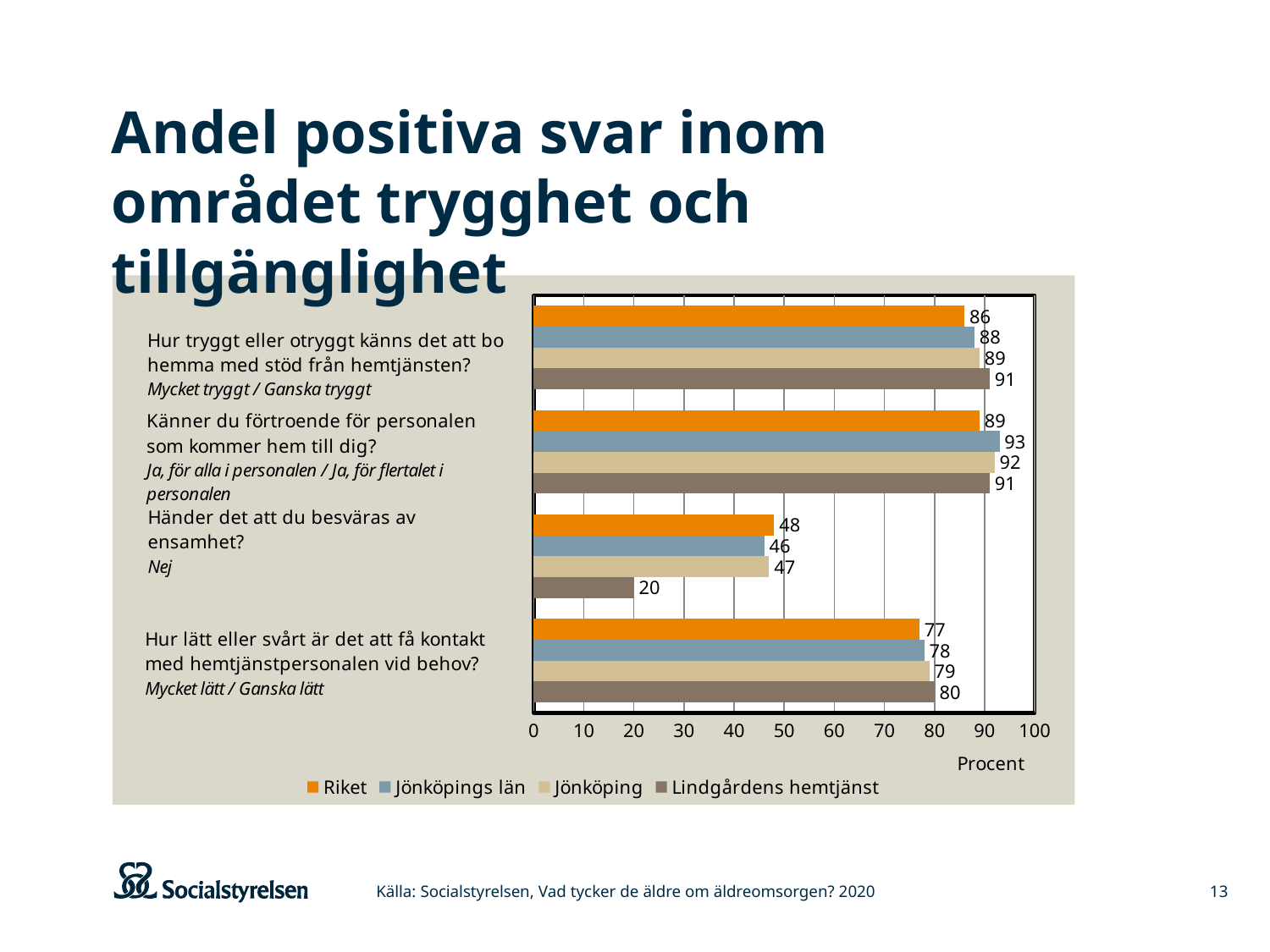
What is the difference between Riket and Lindgårdens hemtjänst on the question 'Händer det att du besväras av ensamhet?'? 28 What is the value for Lindgårdens hemtjänst on the question 'Händer det att du besväras av ensamhet?'? 20 What unit is shown on the horizontal axis of the chart? Procent How many question categories are plotted on the chart? 4 Which series has the highest value on the question 'Hur tryggt eller otryggt känns det att bo hemma med stöd från hemtjänsten?'? Lindgårdens hemtjänst Which is larger on the question 'Känner du förtroende för personalen som kommer hem till dig?': Riket or Jönköping? Jönköping What is the value for Riket on the question 'Hur lätt eller svårt är det att få kontakt med hemtjänstpersonalen vid behov?'? 77 Which series has the lowest value on the question 'Händer det att du besväras av ensamhet?'? Lindgårdens hemtjänst What type of chart is shown on the slide? bar chart Is the value for Jönköping on the question 'Hur lätt eller svårt är det att få kontakt med hemtjänstpersonalen vid behov?' greater or less than 70? greater What is the value for Jönköpings län on the question 'Känner du förtroende för personalen som kommer hem till dig?'? 93 How many series does the legend list? 4